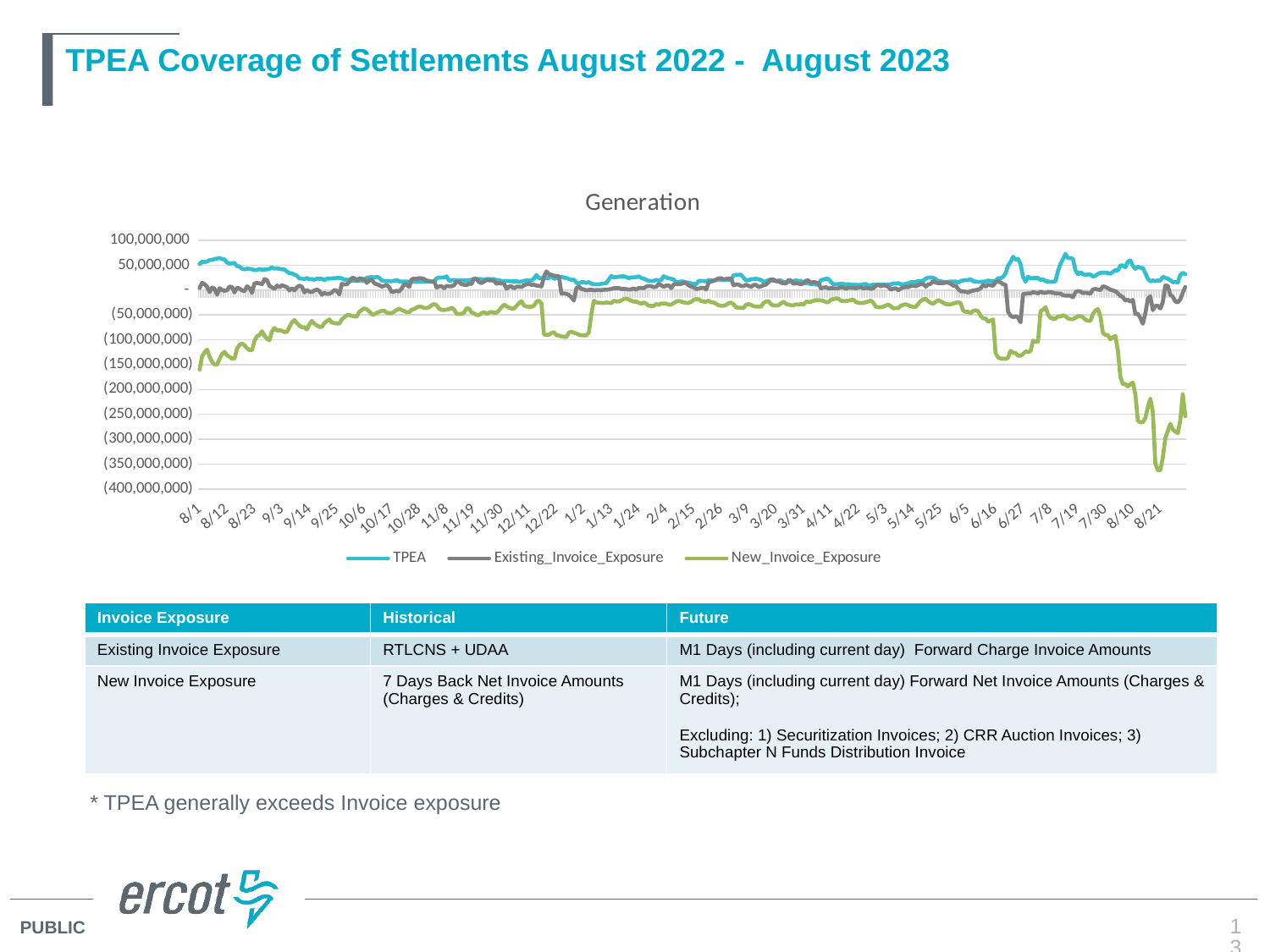
What is the lowest value shown on the vertical axis of the chart? (400,000,000) Is the value of TPEA at 8/1 (the start of the chart) greater or less than 100,000,000? less Is the value of New_Invoice_Exposure at 8/1 (the start of the chart) greater or less than (100,000,000)? less Is the value of TPEA at 8/1 (the start of the chart) greater or less than 0? greater Which series reaches the lowest value anywhere on the chart? New_Invoice_Exposure What kind of chart is shown on the slide? Line chart How many series does the legend of the chart list? 3 Does the New_Invoice_Exposure series generally rise or fall between 8/1 and 10/6? rise What is the title of the chart? Generation At 8/1 (the start of the chart), which series has the higher value, TPEA or New_Invoice_Exposure? TPEA Which series is shown in green in the chart? New_Invoice_Exposure